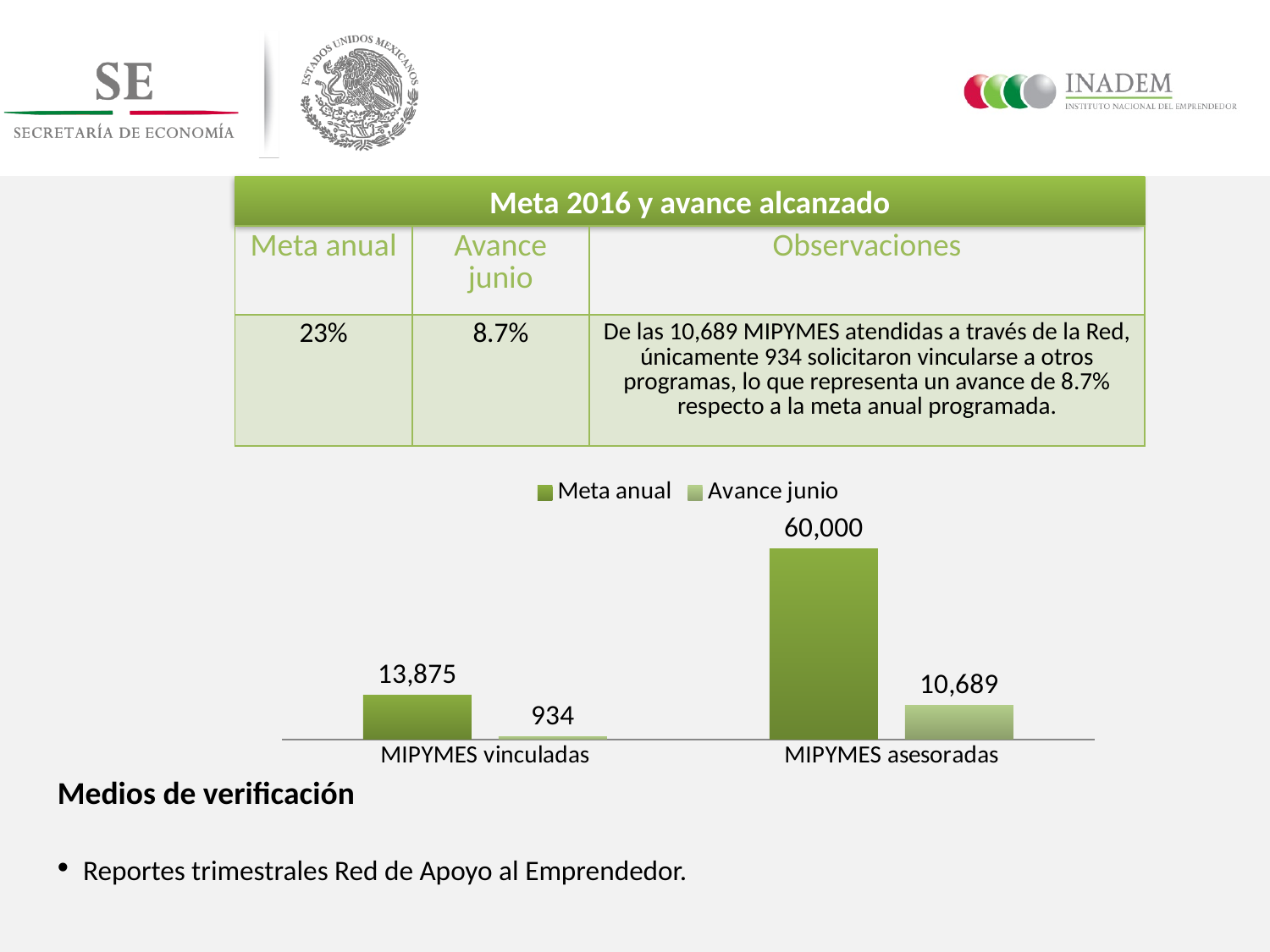
Which category has the lowest Avance junio value? MIPYMES vinculadas How many categories are shown on the x axis of the chart? 2 How many series does the chart legend list? 2 Which category has the highest Meta anual value? MIPYMES asesoradas What is the difference between the Meta anual and Avance junio values for MIPYMES vinculadas? 12,941 What is the Avance junio value for MIPYMES asesoradas? 10,689 What is the difference between the Meta anual and Avance junio values for MIPYMES asesoradas? 49,311 What kind of chart is shown on the slide? Bar chart What is the Meta anual value for MIPYMES asesoradas? 60,000 What is the Avance junio value for MIPYMES vinculadas? 934 Which is larger: the Avance junio value for MIPYMES asesoradas or the Meta anual value for MIPYMES vinculadas? Meta anual for MIPYMES vinculadas What is the Meta anual value for MIPYMES vinculadas? 13,875